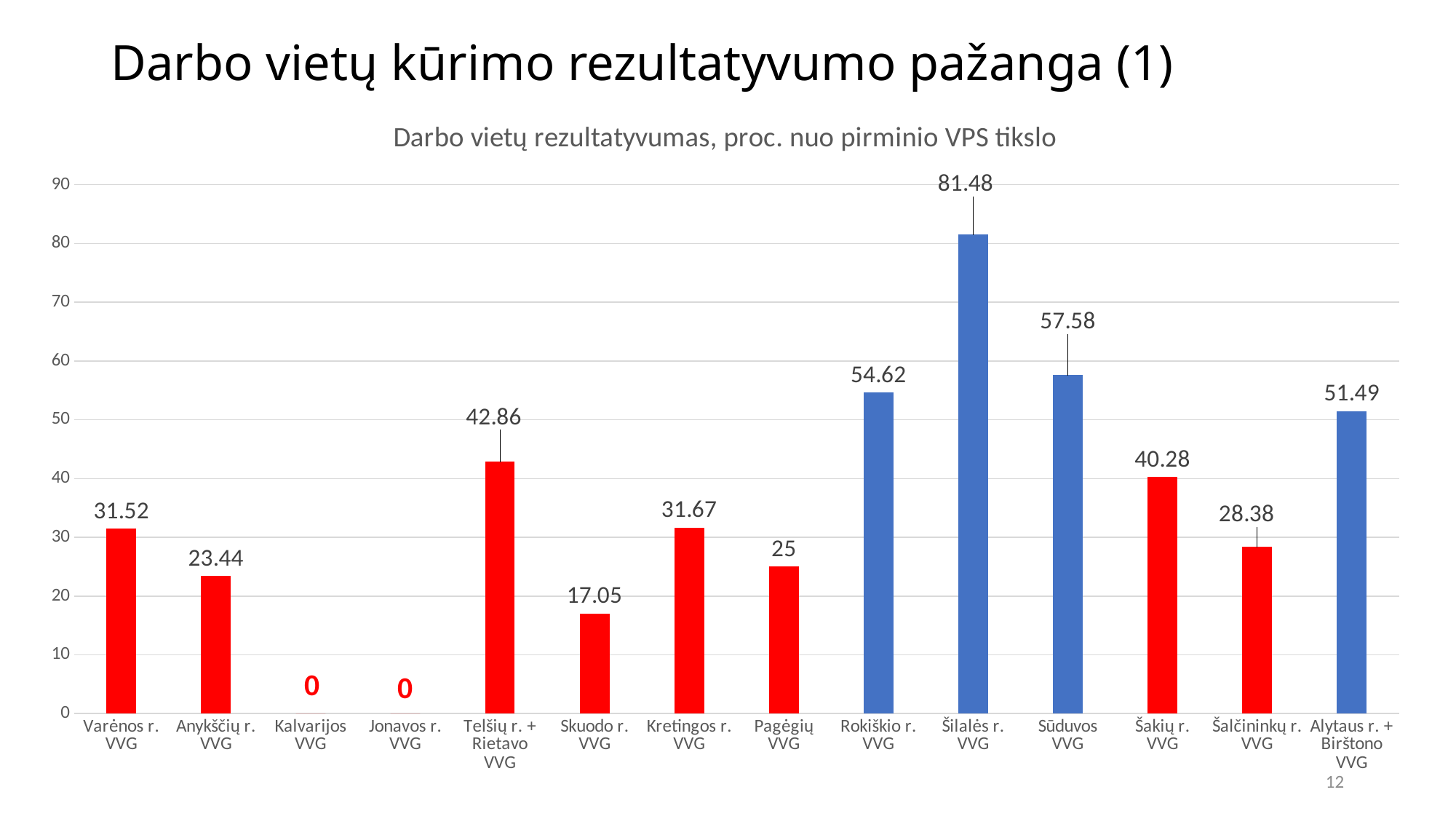
Which categories have a value of 0? Kalvarijos VVG and Jonavos r. VVG Is the value for Alytaus r. + Birštono VVG greater or less than 50? greater What is the value for Šilalės r. VVG? 81.48 What kind of chart is shown on the slide? bar chart Which is larger, the value for Varėnos r. VVG or Kretingos r. VVG? Kretingos r. VVG What is the difference between the values for Sūduvos VVG and Rokiškio r. VVG? 2.96 What is the value for Telšių r. + Rietavo VVG? 42.86 What colour is the bar for Šakių r. VVG? red How many categories are shown on the x axis? 14 What is the value for Šalčininkų r. VVG? 28.38 Which category has the highest value? Šilalės r. VVG What is the title of the chart? Darbo vietų rezultatyvumas, proc. nuo pirminio VPS tikslo